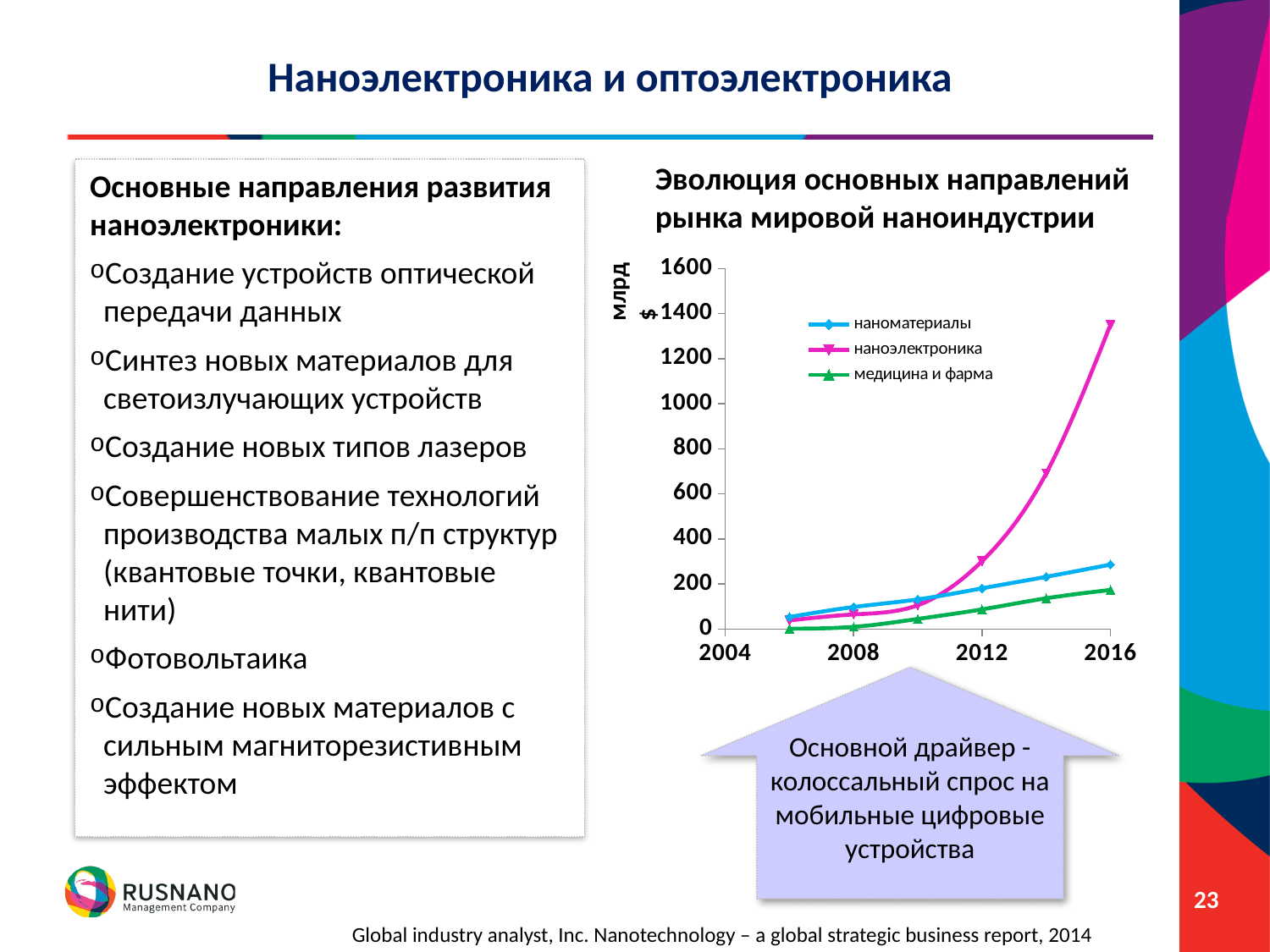
What is the label on the vertical axis of the chart? млрд $ Is the value for наноэлектроника in 2016 greater or less than 1200? greater How many data points does each series have on the chart? 6 Is the value for наноэлектроника in 2014 greater or less than 600? greater What kind of chart is shown on the slide? line chart Is the value for медицина и фарма in 2016 greater or less than 200? less What is the title of the chart? Эволюция основных направлений рынка мировой наноиндустрии Which series has the highest value in 2016? наноэлектроника Which series has the lowest value in 2016? медицина и фарма Does the наноэлектроника series rise or fall from 2006 to 2016? rise How many series does the chart legend list? 3 In 2016, which is larger: наноэлектроника or наноматериалы? наноэлектроника